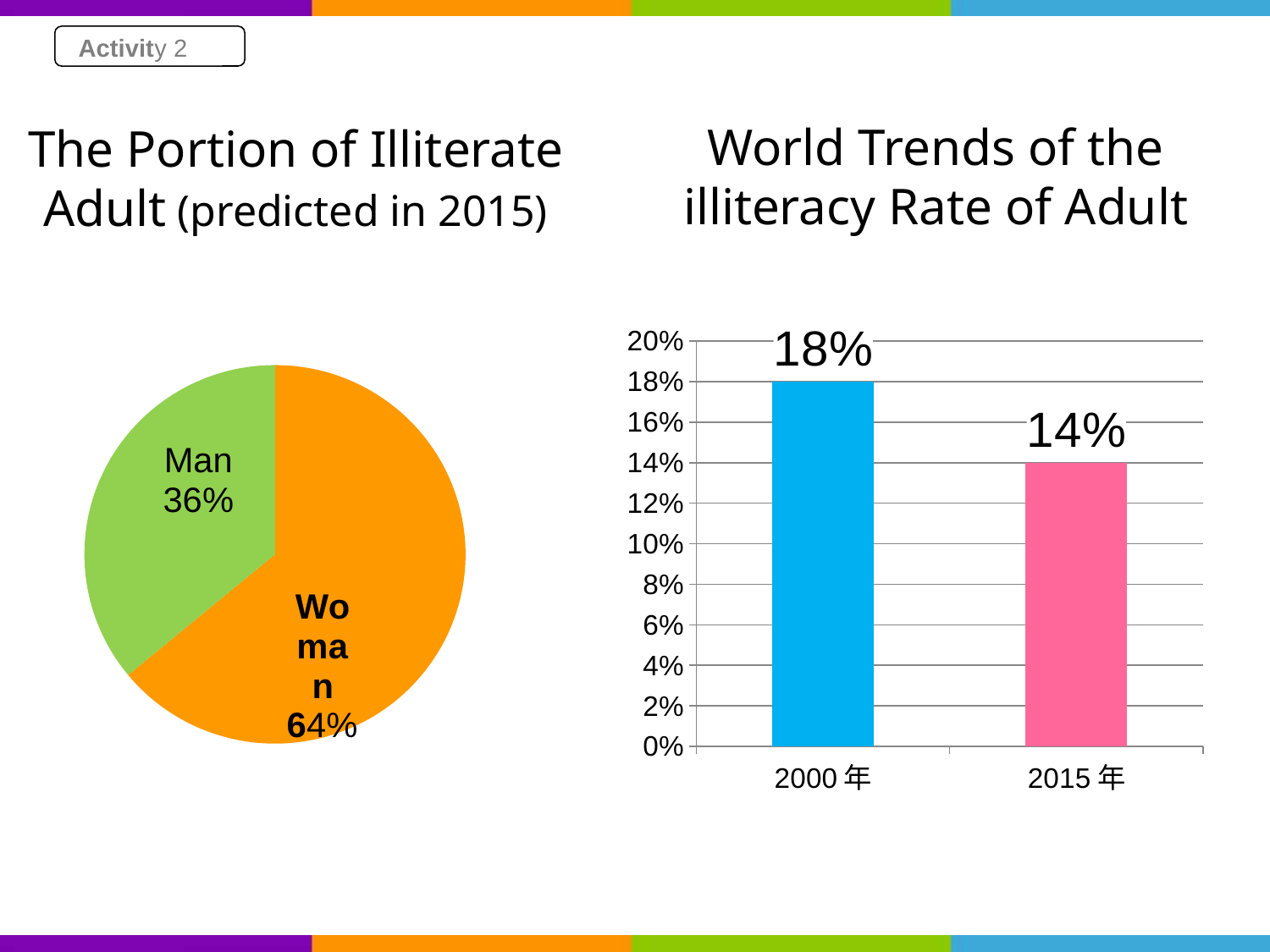
In the pie chart 'The Portion of Illiterate Adult (predicted in 2015)', how many slices are there? 2 In the pie chart 'The Portion of Illiterate Adult (predicted in 2015)', what share is labelled for Man? 36% What type of chart is the left chart, 'The Portion of Illiterate Adult (predicted in 2015)'? Pie chart In the chart 'World Trends of the illiteracy Rate of Adult', what is the value for 2000 年? 18% In the chart 'World Trends of the illiteracy Rate of Adult', what is the difference between the 2000 年 and 2015 年 values? 4% In the pie chart 'The Portion of Illiterate Adult (predicted in 2015)', which slice is larger, Man or Woman? Woman In the pie chart 'The Portion of Illiterate Adult (predicted in 2015)', what share is labelled for Woman? 64% In the chart 'World Trends of the illiteracy Rate of Adult', what is the value for 2015 年? 14% In the pie chart 'The Portion of Illiterate Adult (predicted in 2015)', what is the difference between the Woman and Man shares? 28% In the chart 'World Trends of the illiteracy Rate of Adult', which year has the higher illiteracy rate? 2000 年 What type of chart is the right chart, 'World Trends of the illiteracy Rate of Adult'? Bar chart In the chart 'World Trends of the illiteracy Rate of Adult', do the values rise or fall from 2000 年 to 2015 年? Fall